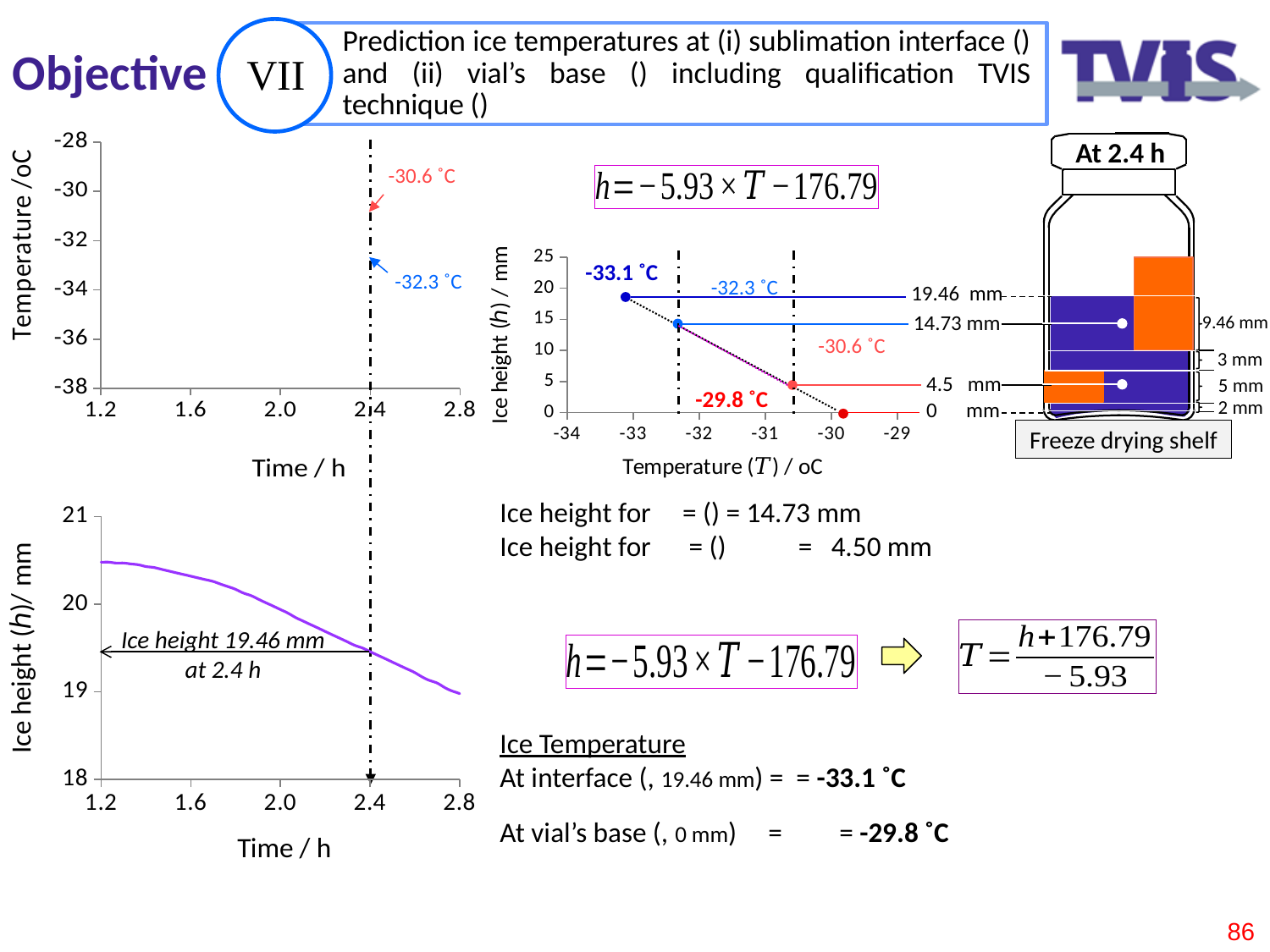
In the middle chart of ice height against temperature, what temperature corresponds to an ice height of 0 mm? -29.8 °C In the bottom-left chart of ice height against time, is the ice height at 1.2 h greater or less than 20 mm? greater In the middle chart of ice height against temperature, what is the ice height at -30.6 °C? 4.5 mm In the bottom-left chart of ice height against time, does the ice height rise or fall as time increases? fall In the middle chart of ice height against temperature, what is the difference between the ice heights at -32.3 °C and -30.6 °C? 10.23 mm In the middle chart of ice height against temperature, which temperature has the larger ice height, -32.3 °C or -30.6 °C? -32.3 °C In the middle chart of ice height against temperature, what temperature corresponds to an ice height of 19.46 mm? -33.1 °C What kind of chart is the bottom-left chart of ice height against time? line chart In the middle chart of ice height against temperature, does the ice height rise or fall as temperature increases along the x axis? fall In the middle chart of ice height against temperature, what is the ice height at -32.3 °C? 14.73 mm In the top-left chart of temperature against time, which two temperatures are annotated at 2.4 h? -30.6 °C and -32.3 °C In the bottom-left chart of ice height against time, what is the ice height at 2.4 h? 19.46 mm